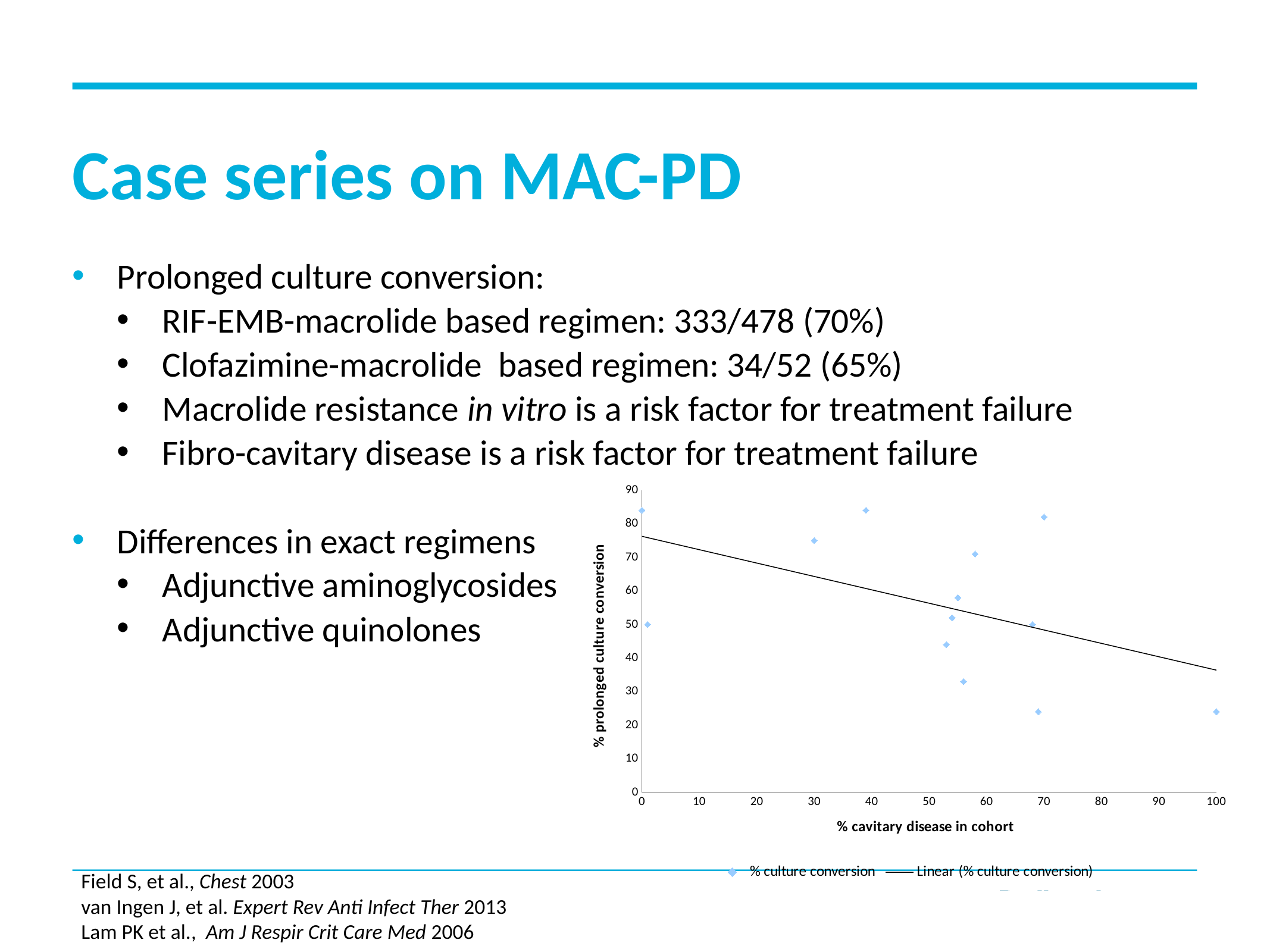
What is the title of the x axis of the chart? % cavitary disease in cohort Is the value of the linear trendline at 0% cavitary disease greater or less than 70? greater How many entries does the chart legend list? 2 What is the highest tick value shown on the y axis of the chart? 90 What is the highest tick value shown on the x axis of the chart? 100 Is the value of the linear trendline at 100% cavitary disease greater or less than 40? less What kind of chart is shown on the slide? scatter chart Is the % prolonged culture conversion for the point at 30% cavitary disease greater or less than 70? greater Does the linear trendline rise or fall as % cavitary disease in cohort increases? falls What is the title of the y axis of the chart? % prolonged culture conversion